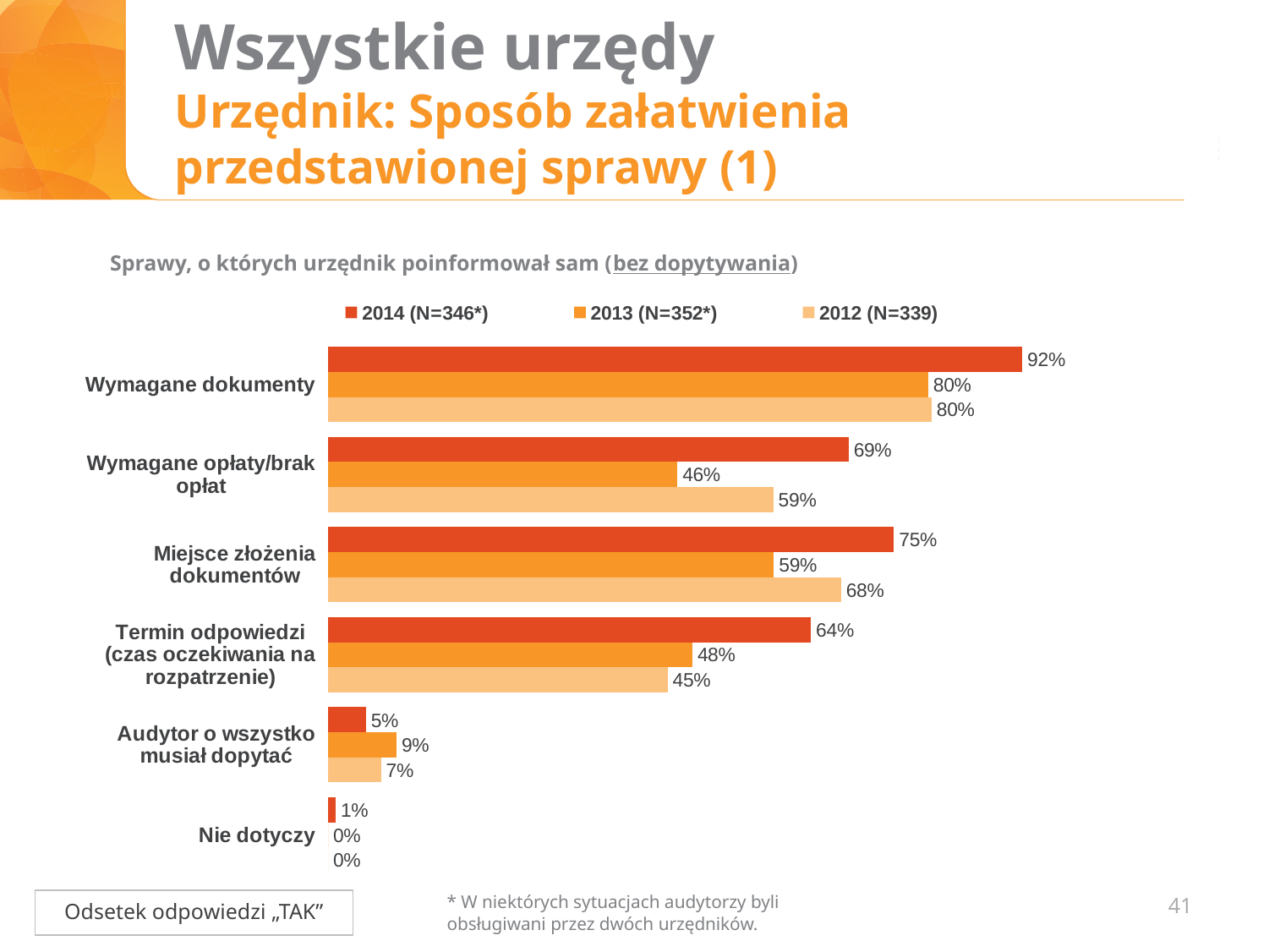
What is the 2014 (N=346*) value for Wymagane dokumenty? 92% How many series does the legend list? 3 What is the subtitle text above the chart? Sprawy, o których urzędnik poinformował sam (bez dopytywania) What is the difference between the 2014 and 2013 values for Termin odpowiedzi (czas oczekiwania na rozpatrzenie)? 16 percentage points For Audytor o wszystko musiał dopytać, which is larger: the 2013 value or the 2012 value? 2013 How many categories are shown on the chart? 6 What is the 2012 (N=339) value for Miejsce złożenia dokumentów? 68% Which category has the highest 2014 (N=346*) value? Wymagane dokumenty What is the 2013 (N=352*) value for Wymagane opłaty/brak opłat? 46% What kind of chart is shown on the slide? Bar chart Which category has the lowest 2013 (N=352*) value? Nie dotyczy What is the 2014 (N=346*) value for Nie dotyczy? 1%